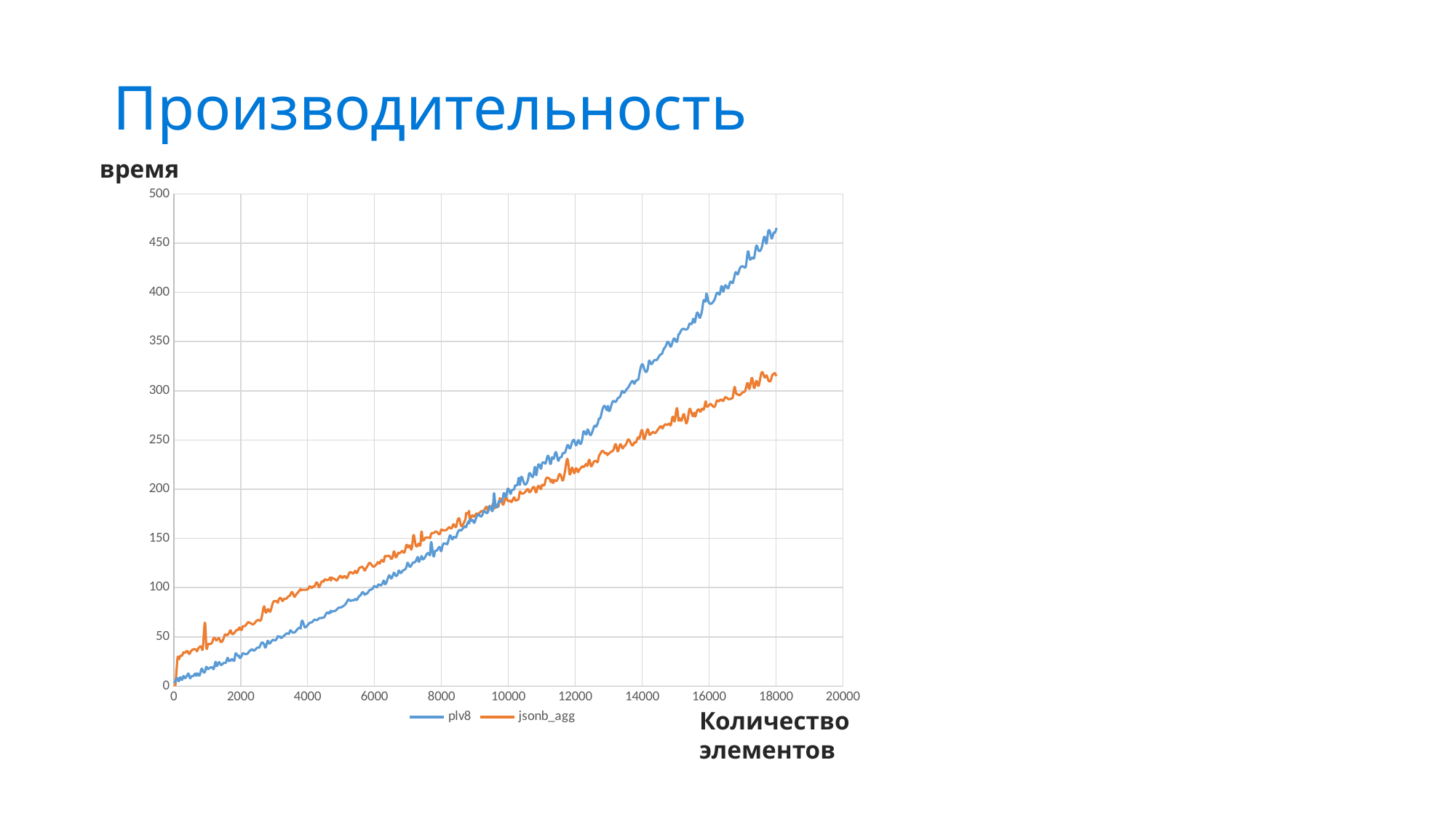
Is the value for jsonb_agg at 2000 elements greater or less than 100? less What are the names of the two series in the legend? plv8 and jsonb_agg At 18000 elements, which series has the higher value, plv8 or jsonb_agg? plv8 Is the value for plv8 at 4000 elements greater or less than 100? less At 4000 elements, which series has the higher value, plv8 or jsonb_agg? jsonb_agg How many series does the legend list? 2 Is the value for plv8 at 18000 elements greater or less than 400? greater What kind of chart is shown on the slide? line chart Do the values of the jsonb_agg series rise or fall along the x axis? rise What is the title of the slide containing the chart? Производительность Do the values of the plv8 series rise or fall as the number of elements increases along the x axis? rise